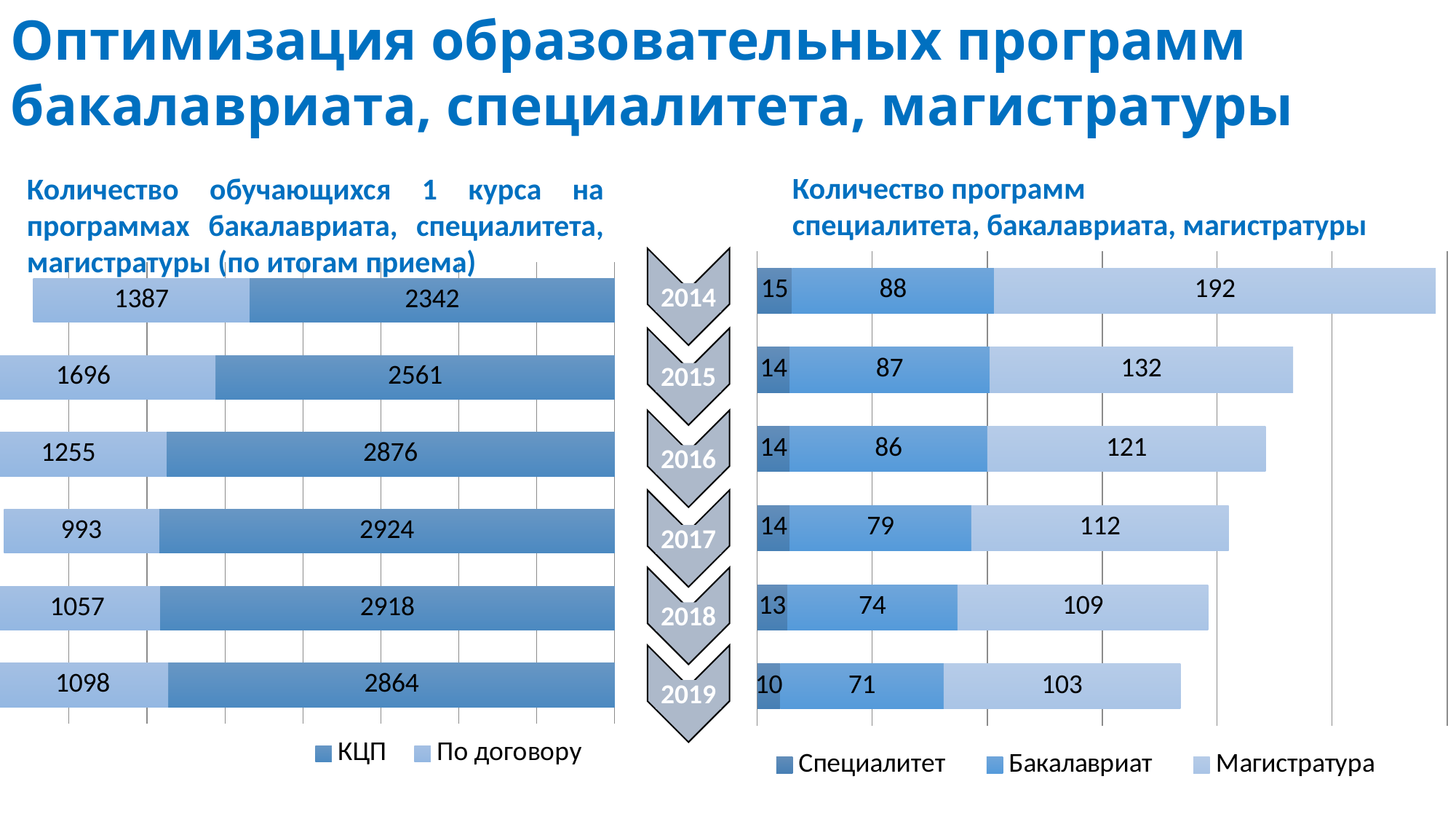
How many series does the legend of the right chart (Количество программ) list? 3 In the right chart (Количество программ), does the Магистратура value rise or fall from 2014 to 2019? fall What kind of chart is the left chart (Количество обучающихся 1 курса)? stacked bar chart In the right chart (Количество программ), what is the total number of programs for 2019? 184 In the left chart (Количество обучающихся 1 курса), what is the КЦП value for 2017? 2924 In the left chart (Количество обучающихся 1 курса), which is larger: the КЦП value for 2016 or for 2019? 2016 In the right chart (Количество программ), what is the difference between the Магистратура values for 2014 and 2019? 89 In the right chart (Количество программ), how many Магистратура programs are shown for 2014? 192 In the left chart (Количество обучающихся 1 курса), what is the По договору value for 2015? 1696 In the right chart (Количество программ), what is the Специалитет value for 2019? 10 In the right chart (Количество программ), which year has the lowest Бакалавриат value? 2019 In the left chart (Количество обучающихся 1 курса), which year has the highest По договору value? 2015